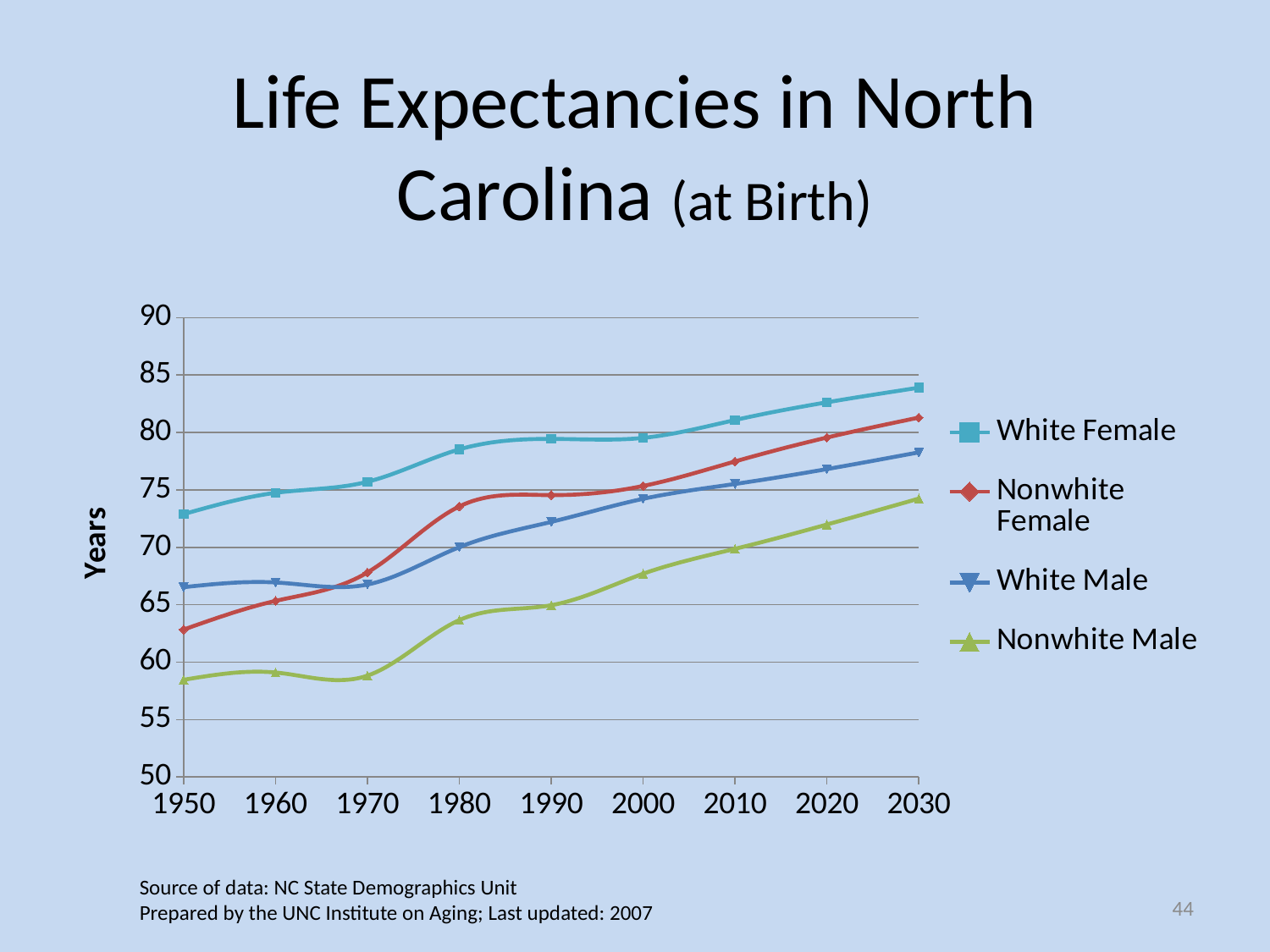
Is the value for White Female in 1950 greater or less than 70? greater Which series has the lowest life expectancy in 1950? Nonwhite Male What type of chart is shown on the slide? Line chart In 1950, which is larger: the value for White Male or the value for Nonwhite Female? White Male Which series has the highest life expectancy in 2030? White Female Does the White Female series rise or fall from 1950 to 2030? Rises Is the value for Nonwhite Female in 2030 greater or less than 80? greater Is the value for White Male in 1990 greater or less than 70? greater How many years are shown along the x axis? 9 What is the title of the y axis? Years How many series does the legend list? 4